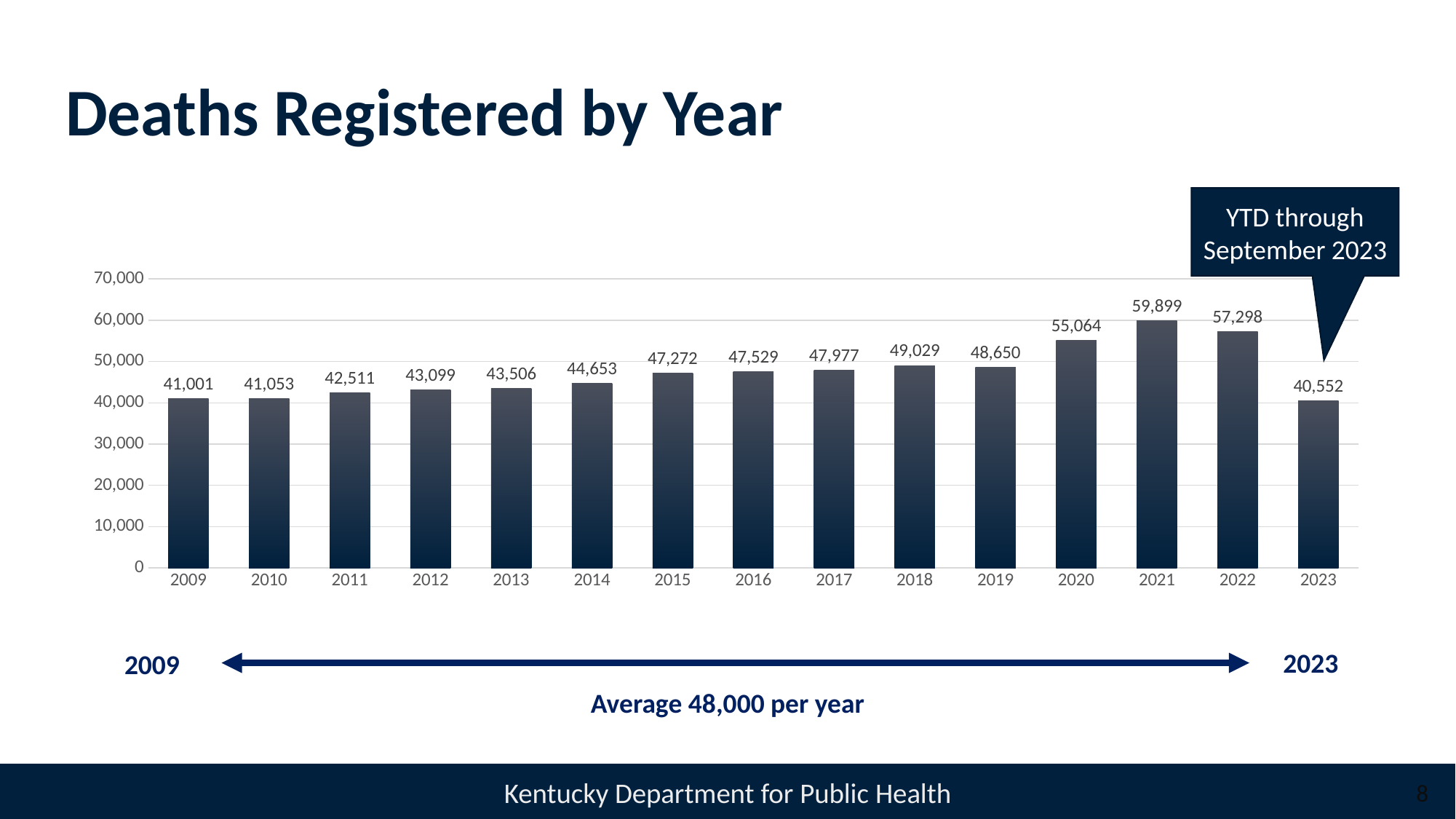
How many deaths were registered in 2021? 59,899 What is the difference between the values for 2020 and 2019? 6,414 How many years are shown on the x axis? 15 What kind of chart is shown on the slide? Bar chart What is the difference between the values for 2021 and 2022? 2,601 What is the value shown for 2023 (YTD through September 2023)? 40,552 What is the value shown for 2009? 41,001 Which year has the highest number of deaths registered? 2021 What average per year is stated below the chart? Average 48,000 per year Which year has a larger value, 2016 or 2018? 2018 Is the value for 2020 greater or less than 50,000? greater Which year has the lowest number of deaths registered? 2023